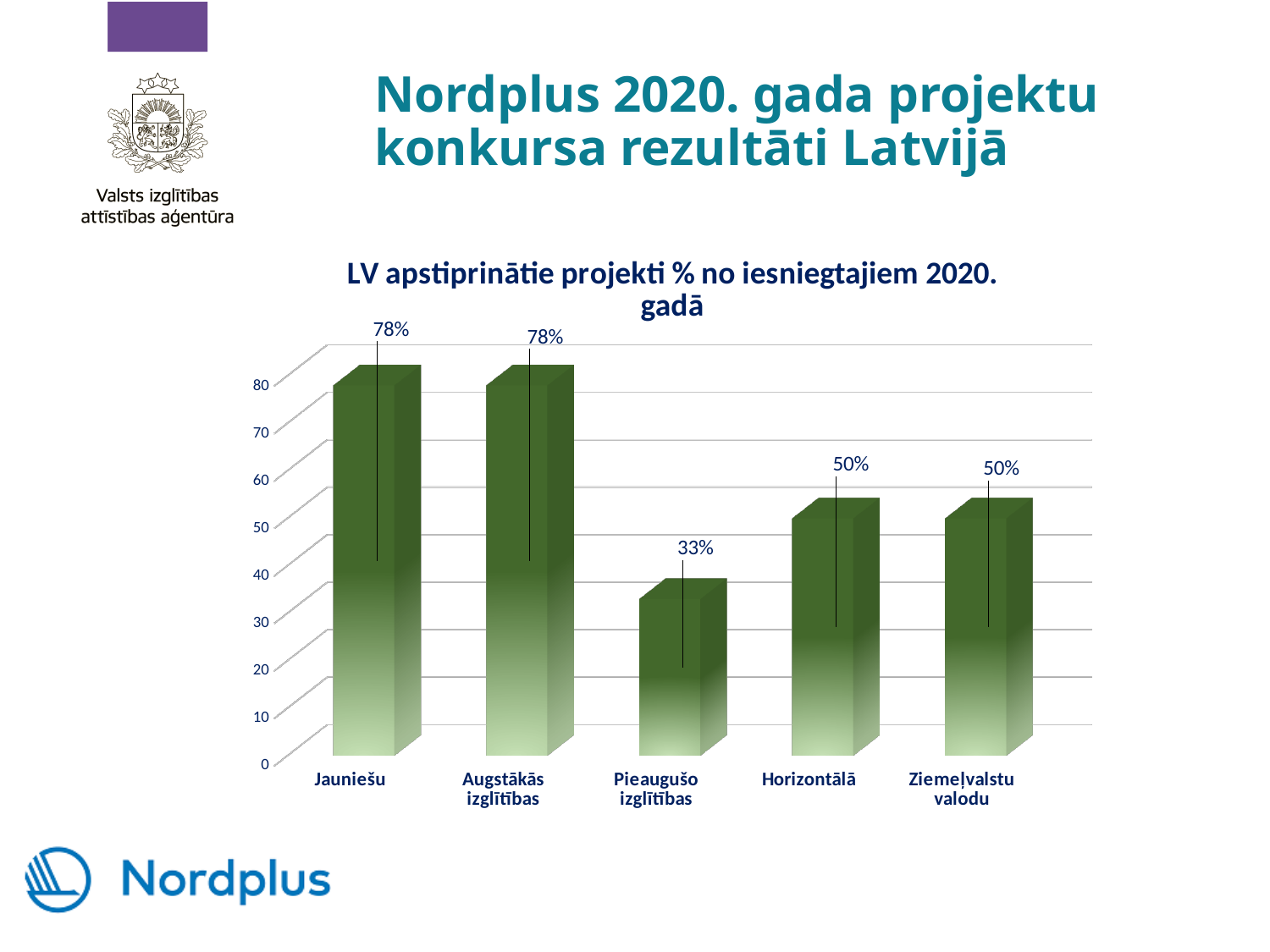
What kind of chart is shown on the slide? bar chart What is the value for Ziemeļvalstu valodu? 50% What is the value for Pieaugušo izglītības? 33% Which is larger, the value for Augstākās izglītības or the value for Horizontālā? Augstākās izglītības Which category has the lowest value? Pieaugušo izglītības What is the difference between the values for Jauniešu and Pieaugušo izglītības? 45 percentage points What is the value for Jauniešu? 78% What is the value for Augstākās izglītības? 78% Is the value for Pieaugušo izglītības greater or less than 40? less What is the value for Horizontālā? 50% What is the difference between the values for Horizontālā and Pieaugušo izglītības? 17 percentage points How many categories are shown on the x axis? 5